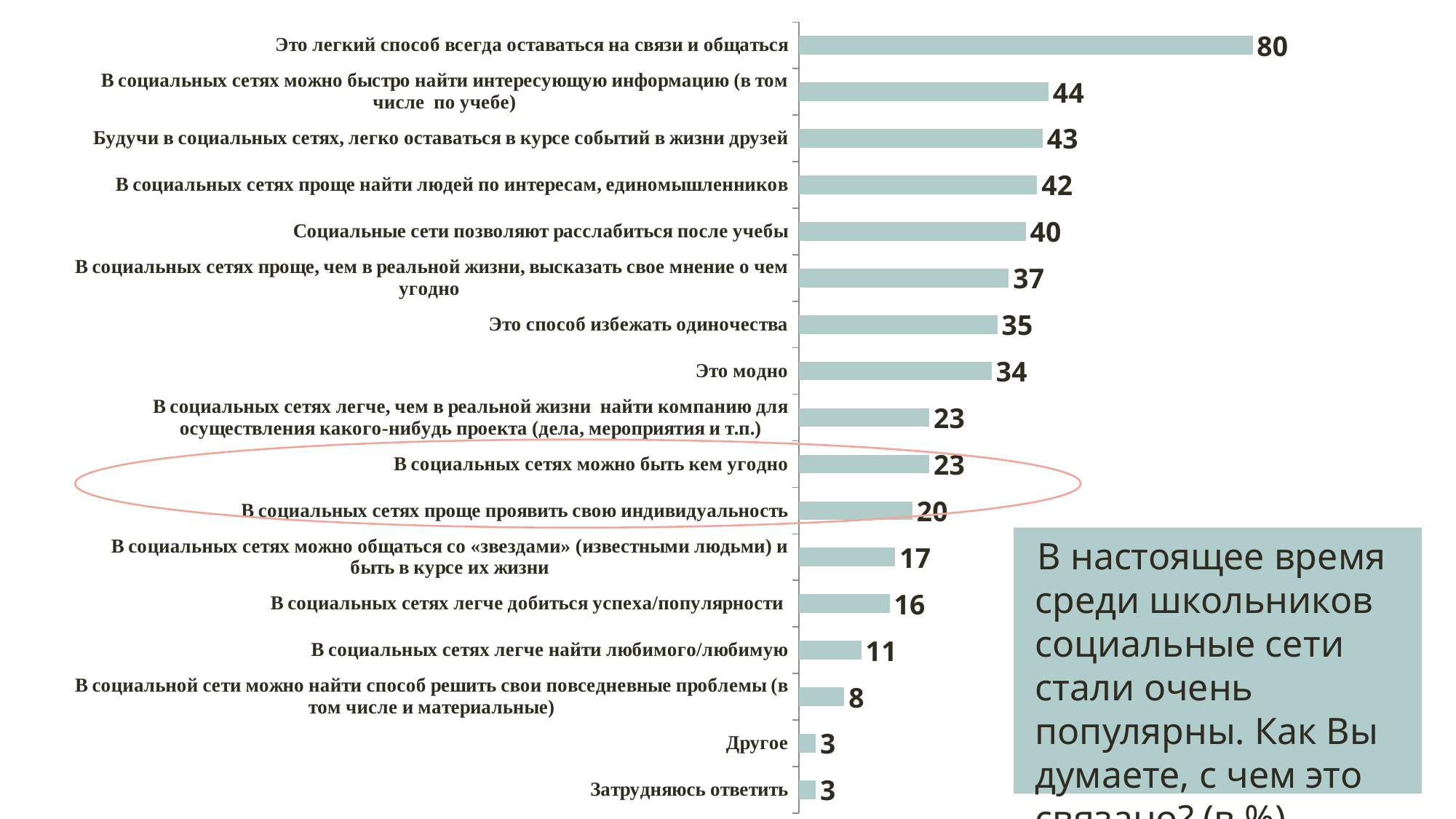
Which two categories are circled on the chart? В социальных сетях можно быть кем угодно; В социальных сетях проще проявить свою индивидуальность What is the value for "Это легкий способ всегда оставаться на связи и общаться"? 80 What is the value for "В социальных сетях проще проявить свою индивидуальность"? 20 What type of chart is shown on the slide? bar chart How many categories are shown in the chart? 17 What is the lowest value shown in the chart? 3 What is the difference between the values for "Социальные сети позволяют расслабиться после учебы" and "Это способ избежать одиночества"? 5 Which is larger: the value for "Это способ избежать одиночества" or the value for "В социальных сетях можно быть кем угодно"? Это способ избежать одиночества Which category has the highest value? Это легкий способ всегда оставаться на связи и общаться What is the value for "В социальных сетях легче найти любимого/любимую"? 11 What is the difference between the values for "Это легкий способ всегда оставаться на связи и общаться" and "В социальных сетях можно быстро найти интересующую информацию (в том числе по учебе)"? 36 What is the value for "Это модно"? 34